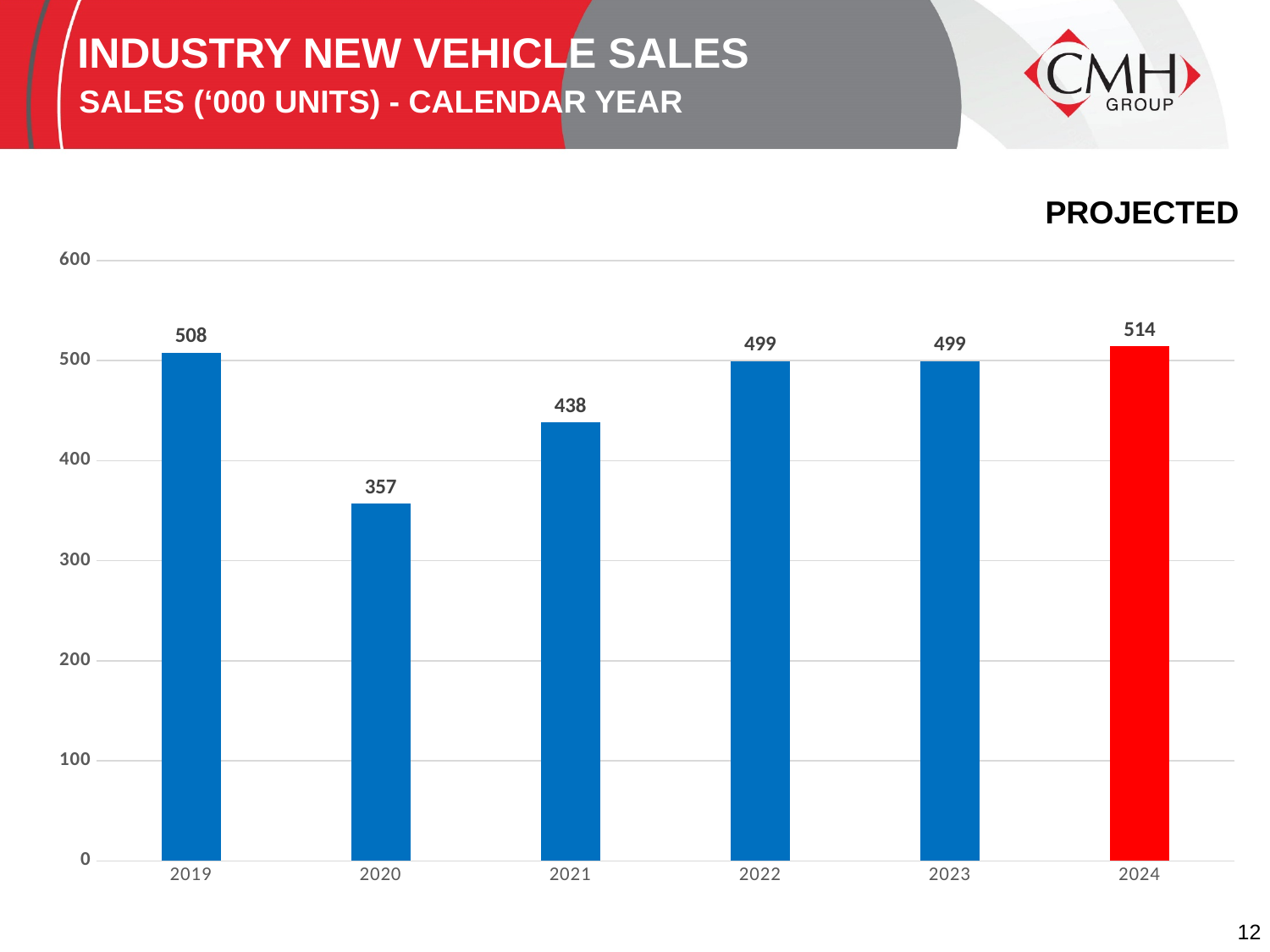
What is the value for 2020? 357 Which year's bar is coloured red? 2024 Which is larger, the value for 2021 or the value for 2022? 2022 Do the values rise or fall from 2020 to 2022? Rise What is the difference between the values for 2019 and 2020? 151 Which year has the highest value? 2024 What is the projected value for 2024? 514 What is the value for 2021? 438 What is the value for 2019? 508 How many years are shown on the chart? 6 Which year has the lowest value? 2020 What kind of chart is shown? Bar chart